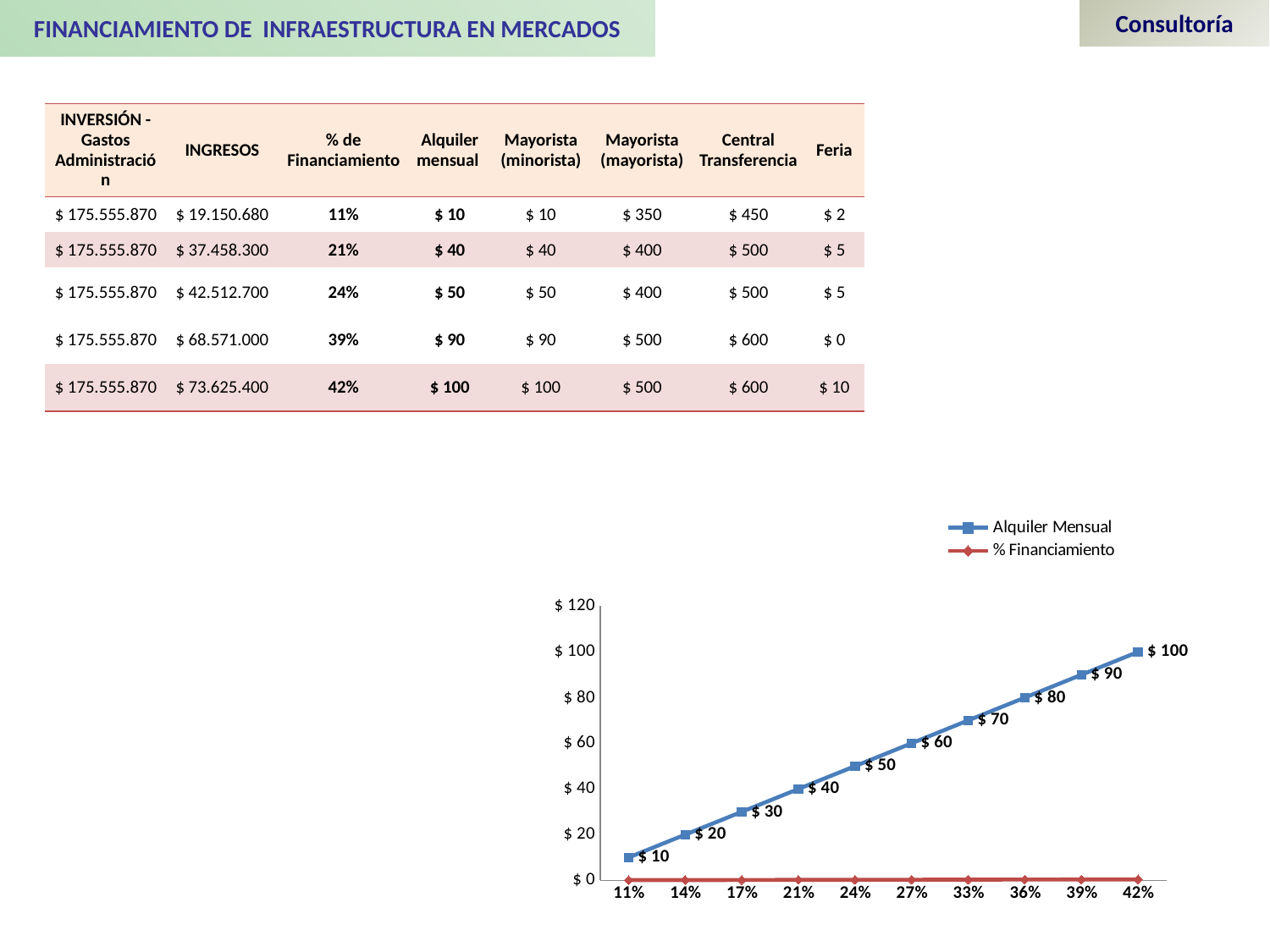
At which x-axis category is Alquiler Mensual lowest on the chart? 11% How many points are plotted along the x axis of the chart? 10 Which is larger on the chart: Alquiler Mensual at 27% or at 17%? 27% How many series does the chart legend list? 2 What is the Alquiler Mensual value at 21% on the chart? $ 40 At which x-axis category is Alquiler Mensual highest on the chart? 42% What type of chart is shown on the slide? line chart What are the two series named in the chart legend? Alquiler Mensual and % Financiamiento Does the Alquiler Mensual line rise or fall as the x axis moves from 11% to 42%? rise What is the Alquiler Mensual value at 36% on the chart? $ 80 What is the Alquiler Mensual value at 11% on the chart? $ 10 What is the difference between the Alquiler Mensual values at 42% and 11% on the chart? $ 90